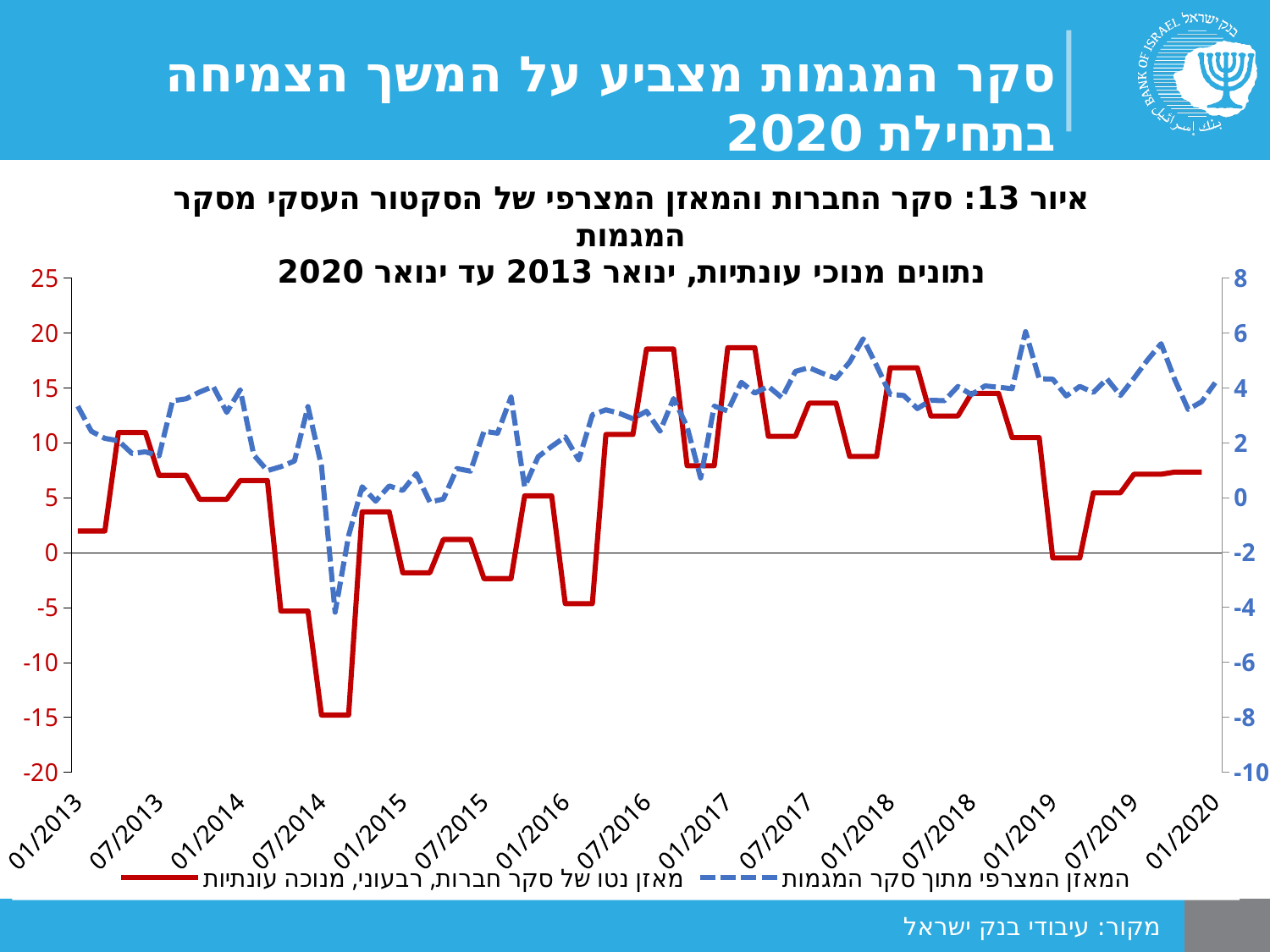
Around which x-axis label does the red solid line (מאזן נטו של סקר חברות) reach its lowest value? 07/2014 What kind of chart is shown on the slide? line chart Is the value of the red solid line (מאזן נטו של סקר חברות) at 01/2013 greater or less than 0? greater How many series does the legend list? 2 Is the value of the red solid line (מאזן נטו של סקר חברות) at its lowest point in 2014 greater or less than -10? less On the right axis, is the peak of the blue dashed line (המאזן המצרפי מתוך סקר המגמות) near 01/2018 greater or less than 4? greater How many date labels are shown along the x axis? 15 What is the highest tick value shown on the left vertical axis? 25 Which series is drawn as a dashed blue line? המאזן המצרפי מתוך סקר המגמות